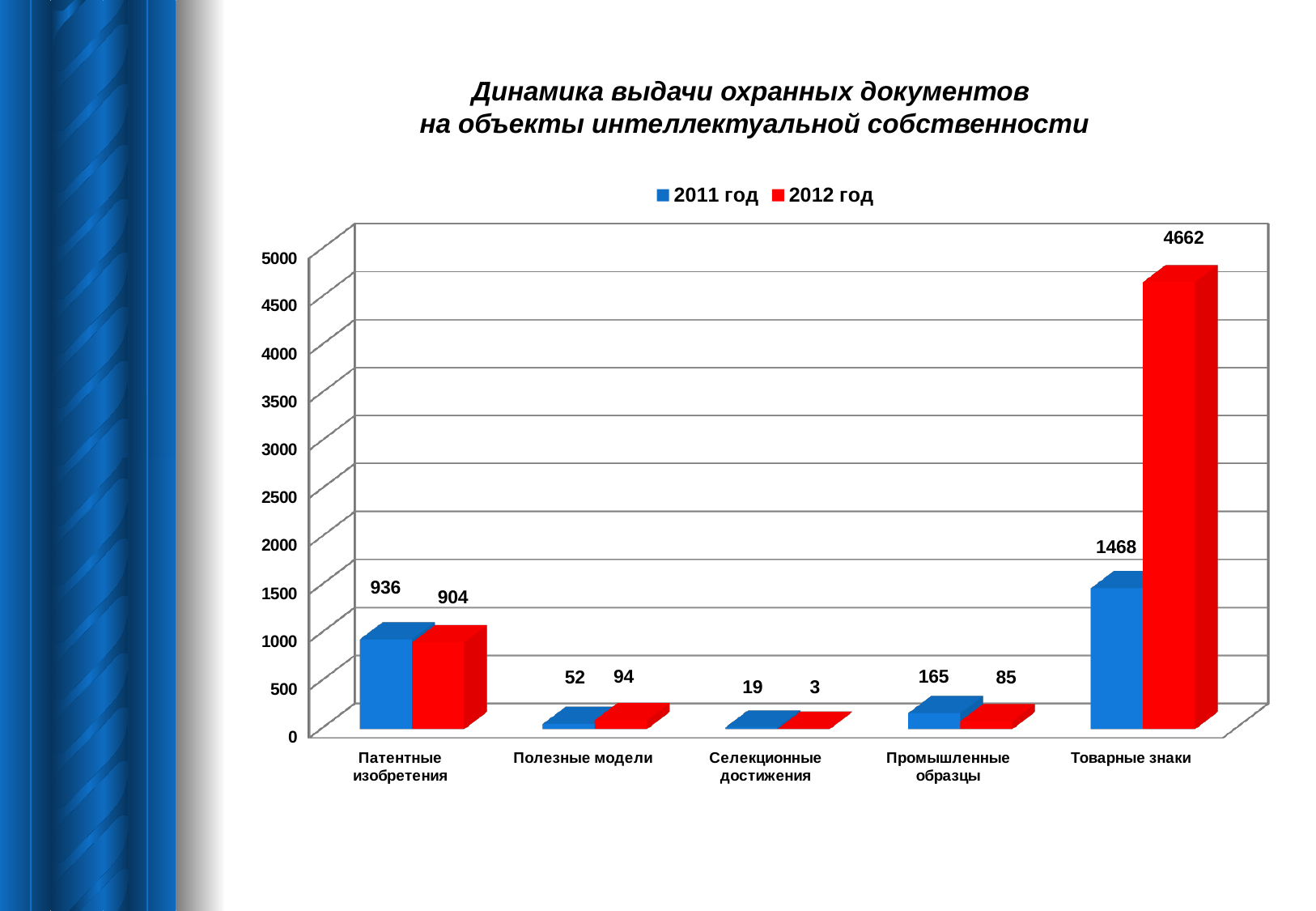
Which is larger for Полезные модели: the 2011 год value or the 2012 год value? 2012 год What is the value for Товарные знаки in the 2012 год series? 4662 Which colour represents the 2012 год series? Red What is the value for Промышленные образцы in the 2011 год series? 165 Which category has the lowest value in the 2011 год series? Селекционные достижения What kind of chart is shown on the slide? Bar chart What is the value for Патентные изобретения in the 2011 год series? 936 Which category has the highest value in the 2012 год series? Товарные знаки What is the difference between the 2012 год and 2011 год values for Товарные знаки? 3194 What is the value for Селекционные достижения in the 2012 год series? 3 How many categories are shown on the x axis? 5 How many series does the legend list? 2